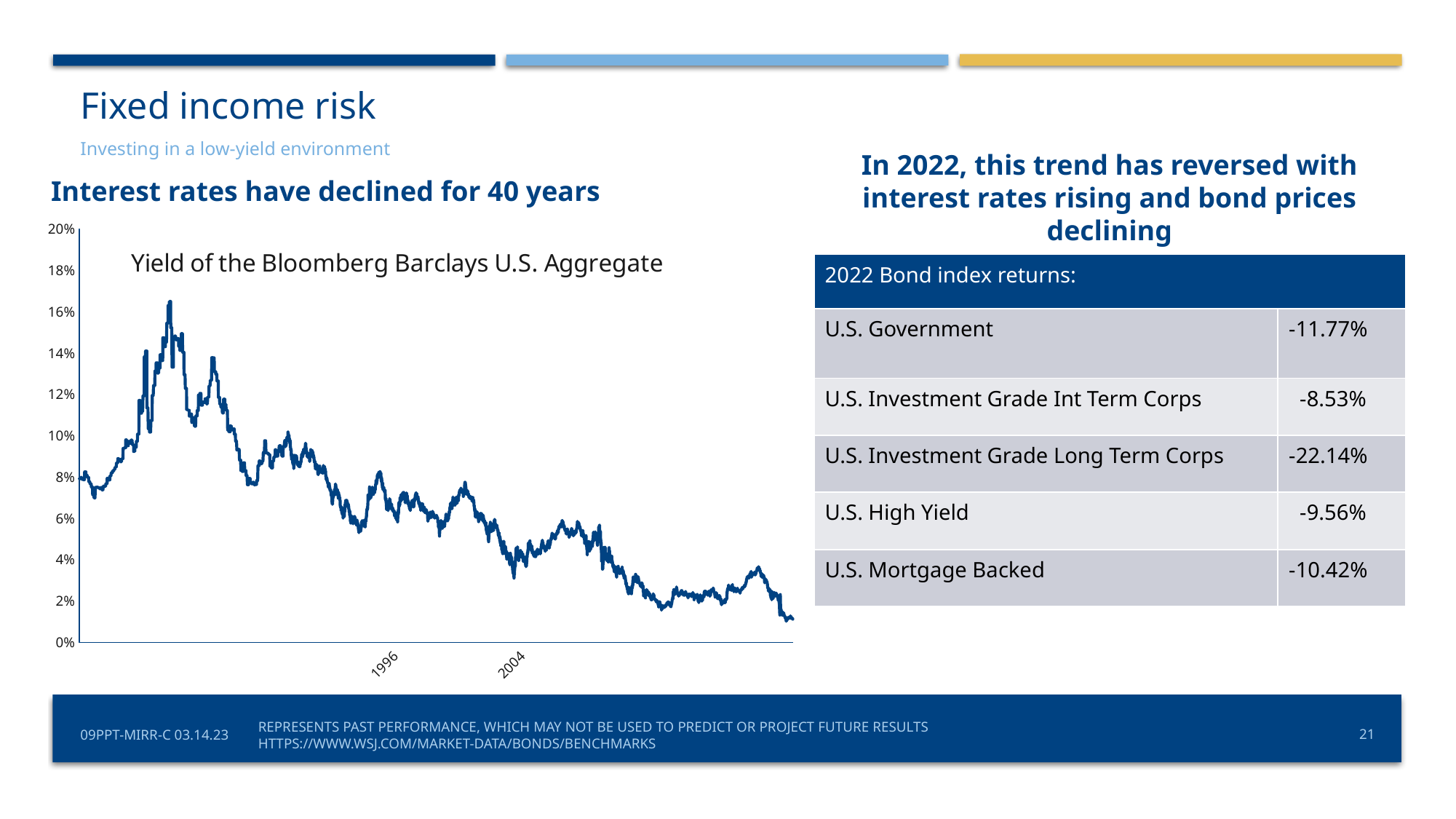
What is the title of the chart on the slide? Yield of the Bloomberg Barclays U.S. Aggregate Overall, do the yield values rise or fall from left to right along the x axis? fall Is the yield value at the 2004 x-axis label greater or less than 2%? greater Is the highest yield value on the chart greater or less than 14%? greater Is the yield value at the 2004 x-axis label greater or less than 6%? less Which is larger, the yield at the 1996 x-axis label or the yield at the 2004 x-axis label? 1996 What kind of chart is shown on the slide? line chart How many year labels are shown on the x axis of the chart? 2 What is the highest value shown on the y axis of the chart? 20%